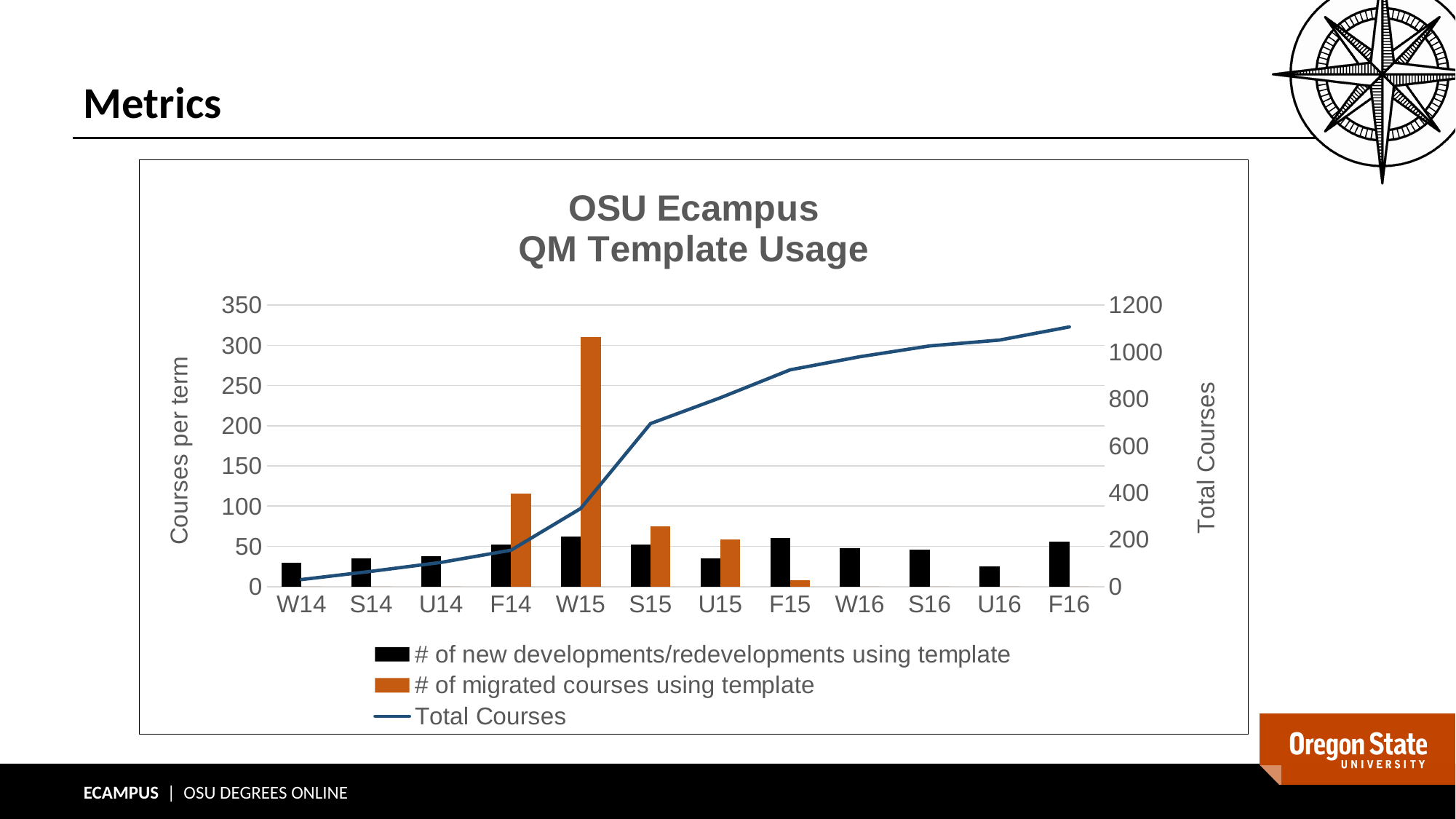
Does the Total Courses line rise or fall from W14 to F16? Rise Is the number of migrated courses using template in F14 greater or less than 100? greater Is the number of new developments/redevelopments using template in W14 greater or less than 50? less What is the title of the chart? OSU Ecampus QM Template Usage What colour are the bars for # of migrated courses using template? Orange Which is larger: the number of migrated courses using template in F14 or in S15? F14 Is the Total Courses value in F16 greater or less than 1000? greater How many terms are shown along the x axis? 12 In which term is the number of migrated courses using template highest? W15 How many series does the legend list? 3 What kind of chart is this? Bar chart with a line